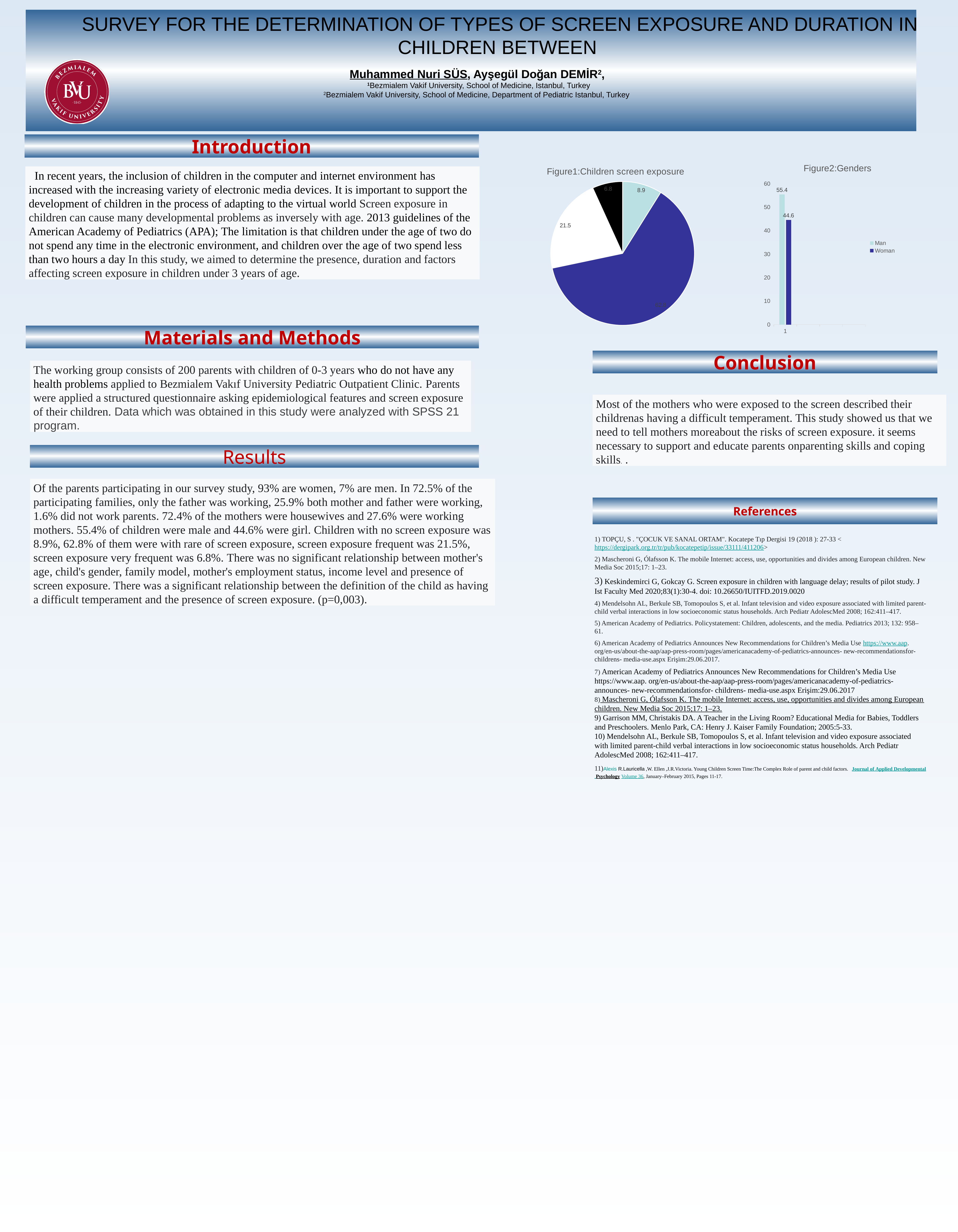
What type of chart is Figure1:Children screen exposure? pie chart In Figure1:Children screen exposure, what is the value of the smallest slice? 6.8 In Figure2:Genders, what is the difference between the Man and Woman values? 10.8 In Figure2:Genders, is the value for Woman greater or less than 50? less How many series does the legend of Figure2:Genders list? 2 In Figure2:Genders, what is the value for Man? 55.4 In Figure2:Genders, what is the highest value shown on the vertical axis? 60 How many slices does the pie in Figure1:Children screen exposure have? 4 What type of chart is Figure2:Genders? bar chart In Figure2:Genders, which series has the higher value, Man or Woman? Man In Figure1:Children screen exposure, what is the value labelled on the white slice? 21.5 In Figure2:Genders, what is the value for Woman? 44.6